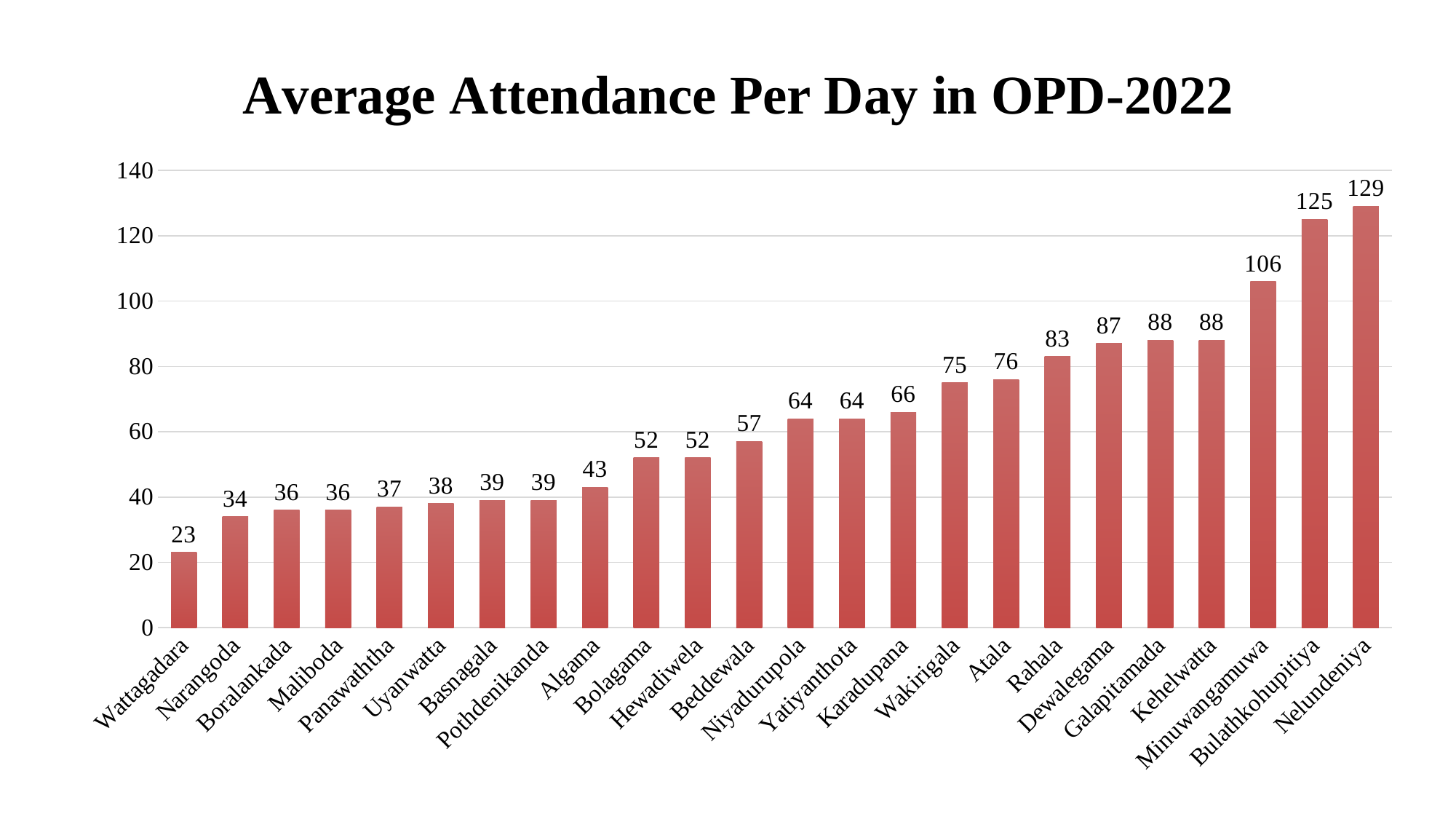
What is the difference in average attendance per day between Rahala and Narangoda? 49 What kind of chart is shown on the slide? Bar chart What is the title of the chart? Average Attendance Per Day in OPD-2022 What is the average attendance per day for Wakirigala? 75 Which hospital has the highest average attendance per day? Nelundeniya Which hospital has the lowest average attendance per day? Wattagadara What is the average attendance per day for Minuwangamuwa? 106 What is the difference in average attendance per day between Nelundeniya and Bulathkohupitiya? 4 Which has a higher average attendance per day, Algama or Karadupana? Karadupana What is the average attendance per day for Beddewala? 57 Is the value for Dewalegama greater or less than 80? greater How many hospitals are shown on the chart? 24